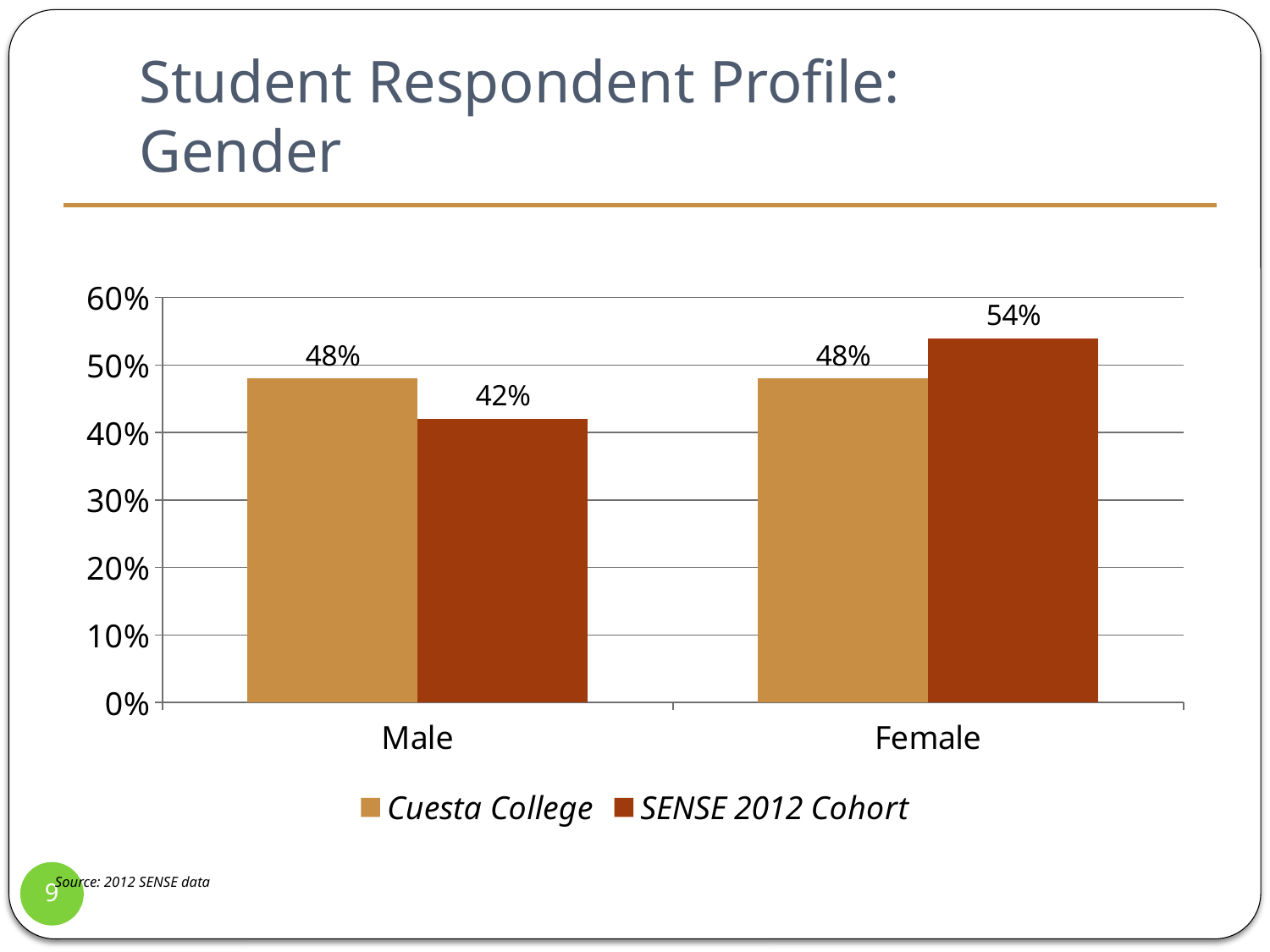
What is the value for SENSE 2012 Cohort in the Female category? 54% How many categories are shown on the x axis? 2 How many series does the legend list? 2 What is the value for Cuesta College in the Male category? 48% What is the value for SENSE 2012 Cohort in the Male category? 42% Which category has the lowest value for the SENSE 2012 Cohort series? Male What is the difference between the SENSE 2012 Cohort values for Female and Male? 12% In the Female category, which series has the larger value, Cuesta College or SENSE 2012 Cohort? SENSE 2012 Cohort What is the value for Cuesta College in the Female category? 48% What kind of chart is shown on the slide? Bar chart In the Male category, which series has the larger value, Cuesta College or SENSE 2012 Cohort? Cuesta College Which category has the highest value for the SENSE 2012 Cohort series? Female